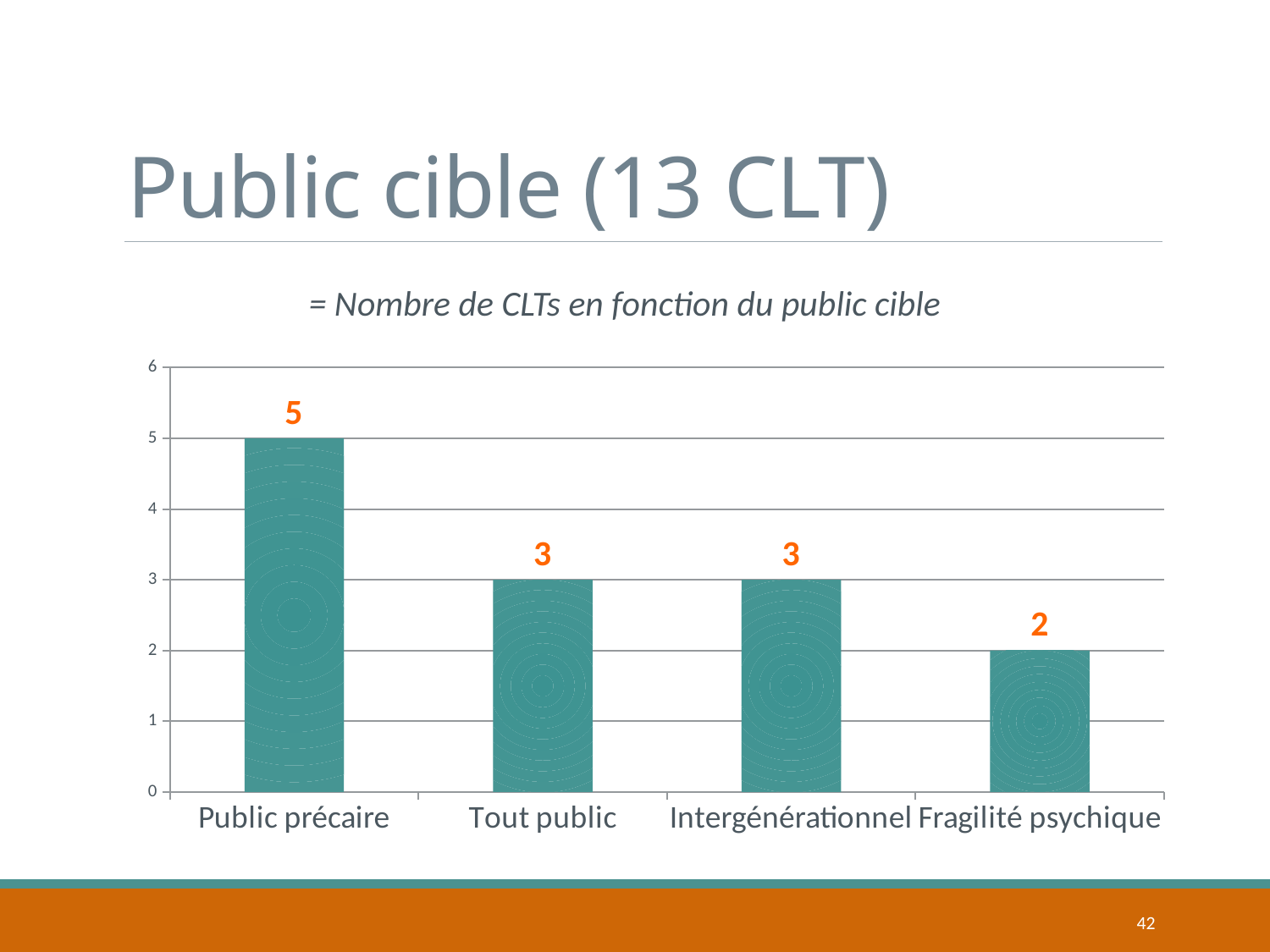
What is the value for Fragilité psychique? 2 What is the value for Public précaire? 5 What is the difference between the values for Public précaire and Fragilité psychique? 3 What is the value for Tout public? 3 Which category has the highest value? Public précaire What is the title of the slide? Public cible (13 CLT) How many categories are shown on the x axis? 4 What is the value for Intergénérationnel? 3 Is the value for Public précaire greater or less than 4? greater Which category has the lowest value? Fragilité psychique Which is larger, the value for Public précaire or the value for Tout public? Public précaire What kind of chart is shown on the slide? bar chart